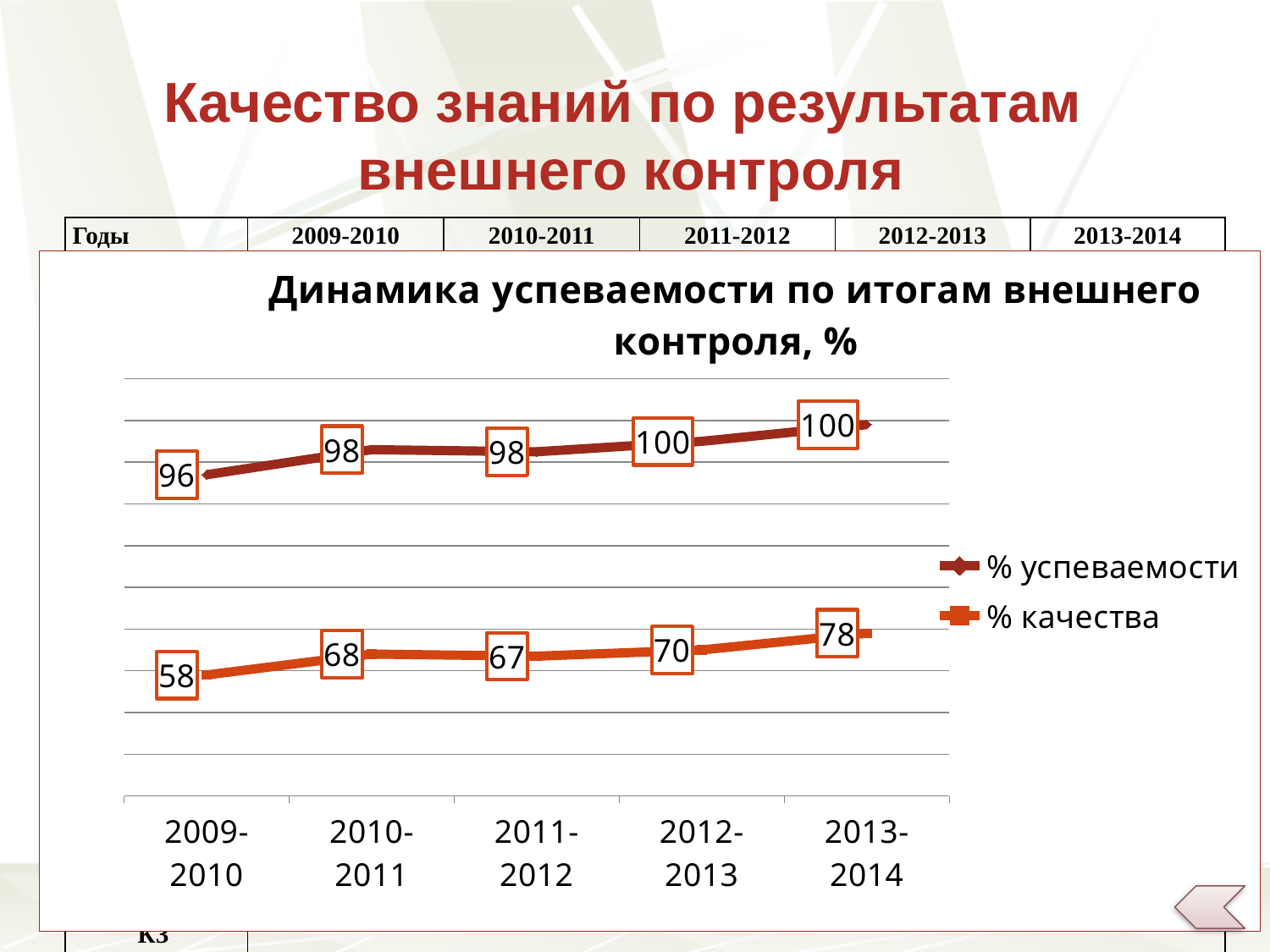
Does % успеваемости generally rise or fall from 2009-2010 to 2013-2014? rise What is the value of % качества for 2011-2012? 67 In which year is % качества highest? 2013-2014 What is the value of % успеваемости for 2009-2010? 96 What kind of chart is shown? line chart In which year is % качества lowest? 2009-2010 Which is larger, % качества in 2010-2011 or in 2011-2012? 2010-2011 By how much did % качества change from 2012-2013 to 2013-2014? 8 How many series does the legend list? 2 What is the value of % успеваемости for 2012-2013? 100 What is the difference between % успеваемости and % качества in 2009-2010? 38 What is the value of % качества for 2013-2014? 78